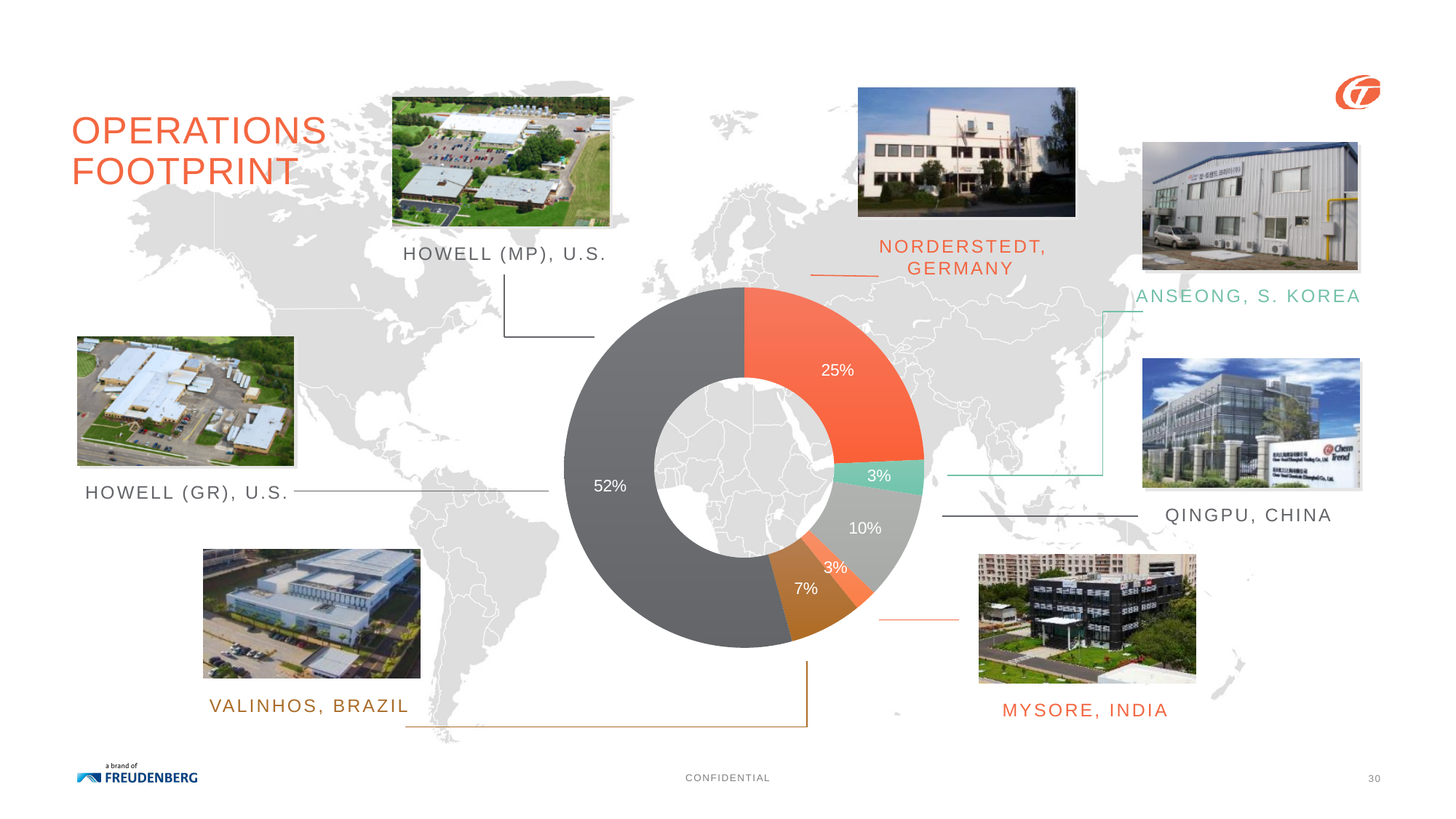
What is the difference between the light gray slice (10%) and the brown slice (7%)? 3% How many slices does the donut chart have? 6 What percentage is shown on the orange slice of the donut chart? 25% What is the title of the slide containing the donut chart? OPERATIONS FOOTPRINT What percentage is shown on the light gray slice of the donut chart? 10% What is the difference between the largest slice (52%) and the orange slice (25%)? 27% What is the value of the smallest slice in the donut chart? 3% What percentage is shown on the teal slice of the donut chart? 3% What kind of chart is shown on the slide? Donut (pie) chart Which is larger, the orange slice or the light gray slice? The orange slice (25%) What is the value of the largest slice in the donut chart? 52% What percentage is shown on the brown slice of the donut chart? 7%